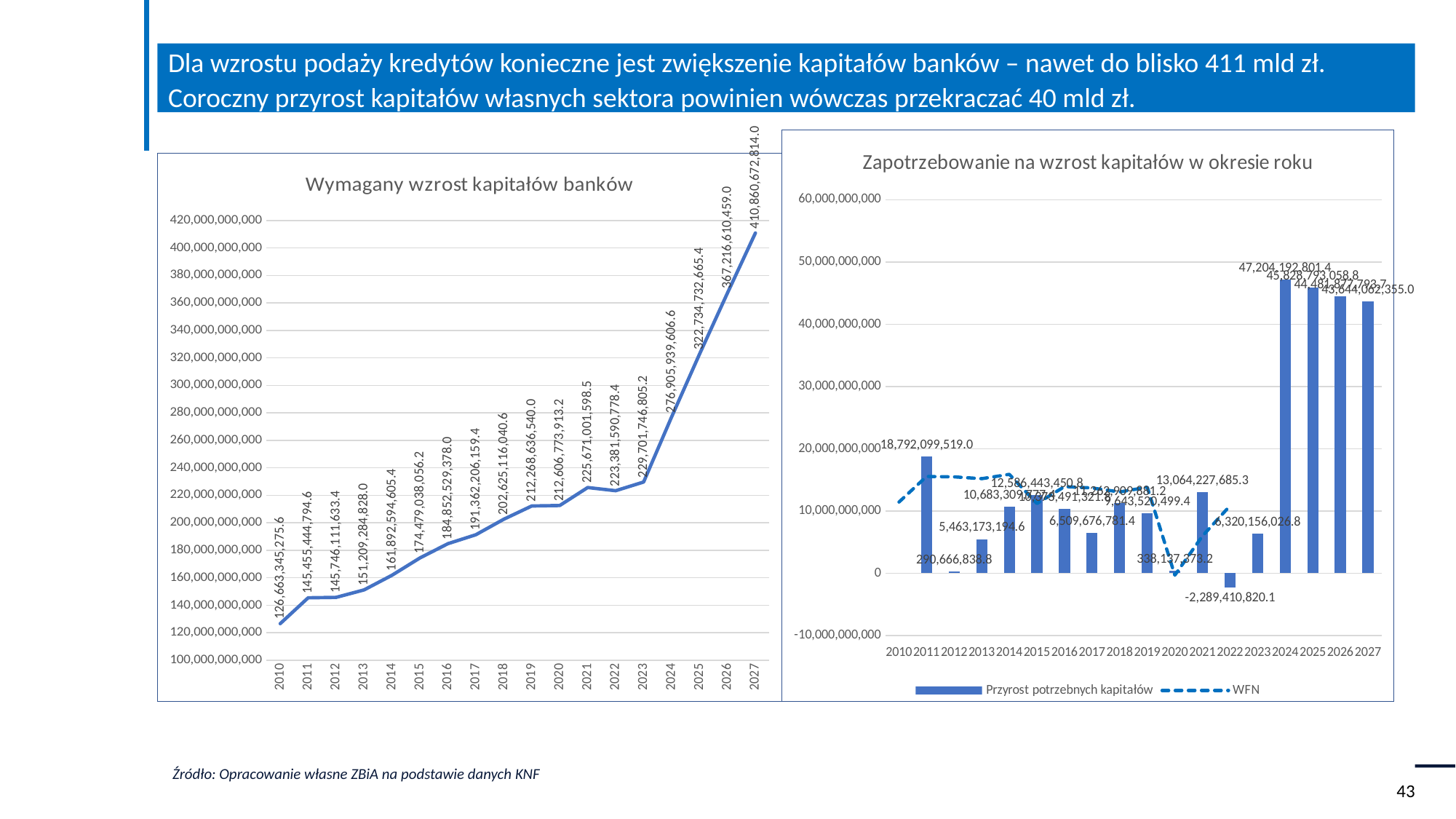
In the chart "Zapotrzebowanie na wzrost kapitałów w okresie roku", is the bar for 2011 or the bar for 2013 larger? 2011 What kind of chart is the left chart titled "Wymagany wzrost kapitałów banków"? line chart In the chart "Wymagany wzrost kapitałów banków", what is the value for 2010? 126,663,345,275.6 In the chart "Zapotrzebowanie na wzrost kapitałów w okresie roku", which year has the tallest bar? 2024 In the chart "Wymagany wzrost kapitałów banków", do the values generally rise or fall from 2010 to 2027? rise How many series does the legend of the chart "Zapotrzebowanie na wzrost kapitałów w okresie roku" list? 2 In the chart "Wymagany wzrost kapitałów banków", what is the value for 2027? 410,860,672,814.0 In the chart "Wymagany wzrost kapitałów banków", how many years are plotted on the x axis? 18 In the chart "Wymagany wzrost kapitałów banków", what is the difference between the values for 2027 and 2026? 43,644,062,355.0 In the chart "Zapotrzebowanie na wzrost kapitałów w okresie roku", what is the value of the bar for 2022? -2,289,410,820.1 In the chart "Zapotrzebowanie na wzrost kapitałów w okresie roku", what is the value of the bar for 2024? 47,204,192,801.4 In the chart "Wymagany wzrost kapitałów banków", which year has the lowest value? 2010